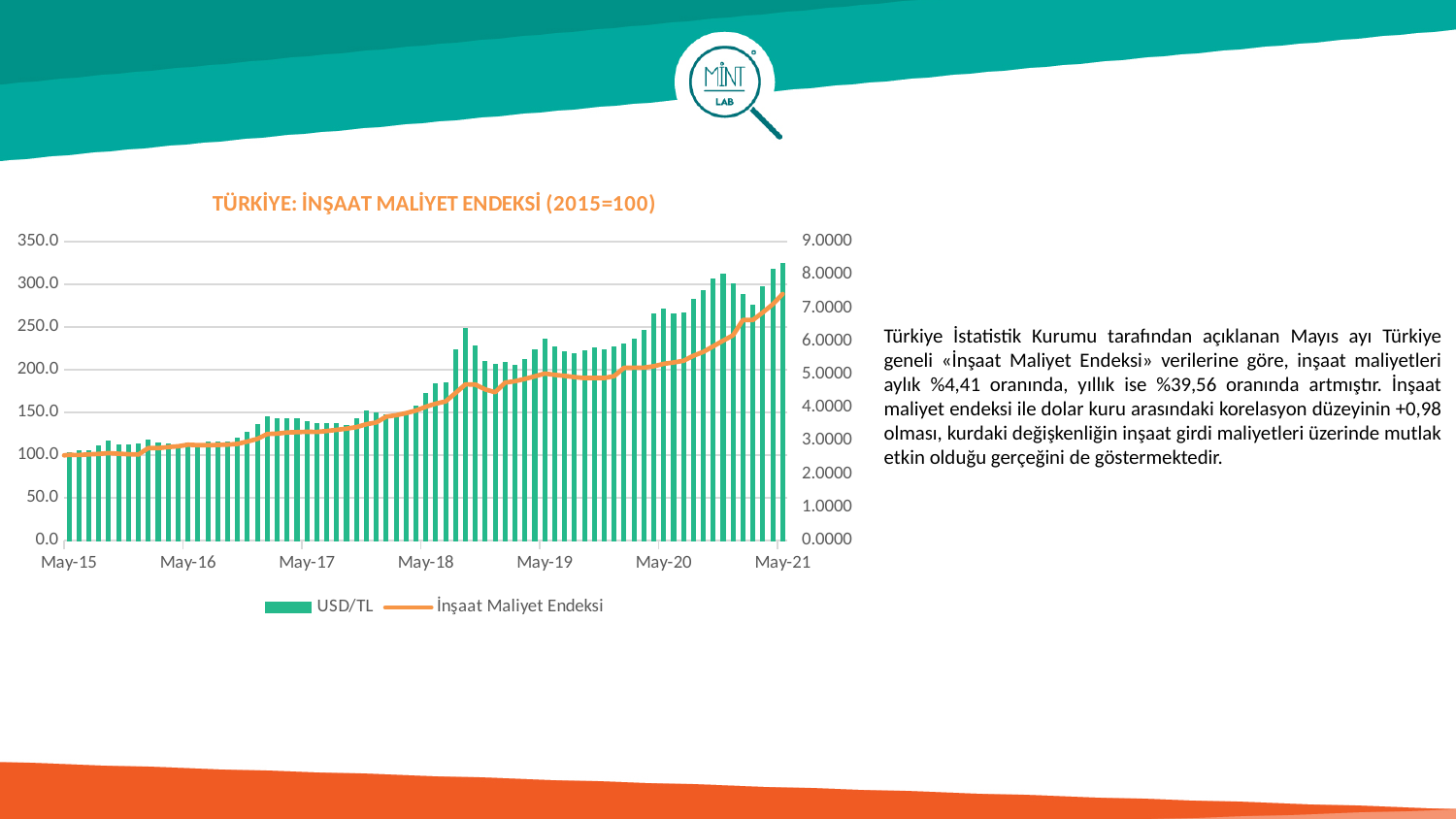
Is the İnşaat Maliyet Endeksi value at May-17 greater or less than 150.0? less Is the İnşaat Maliyet Endeksi value at May-21 greater or less than 250.0? greater Is the USD/TL value at May-20 larger or smaller than at May-18? Larger Which series is drawn as bars in the chart? USD/TL What is the title of the chart? TÜRKİYE: İNŞAAT MALİYET ENDEKSİ (2015=100) Which x-axis label has the lowest USD/TL bar? May-15 Which x-axis label has the highest USD/TL bar? May-21 What kind of chart is shown on the slide? A combined bar and line chart Does the İnşaat Maliyet Endeksi line rise or fall overall from May-15 to May-21? Rise Is the USD/TL value at May-15 greater or less than 3.0000? less How many series does the chart legend list? 2